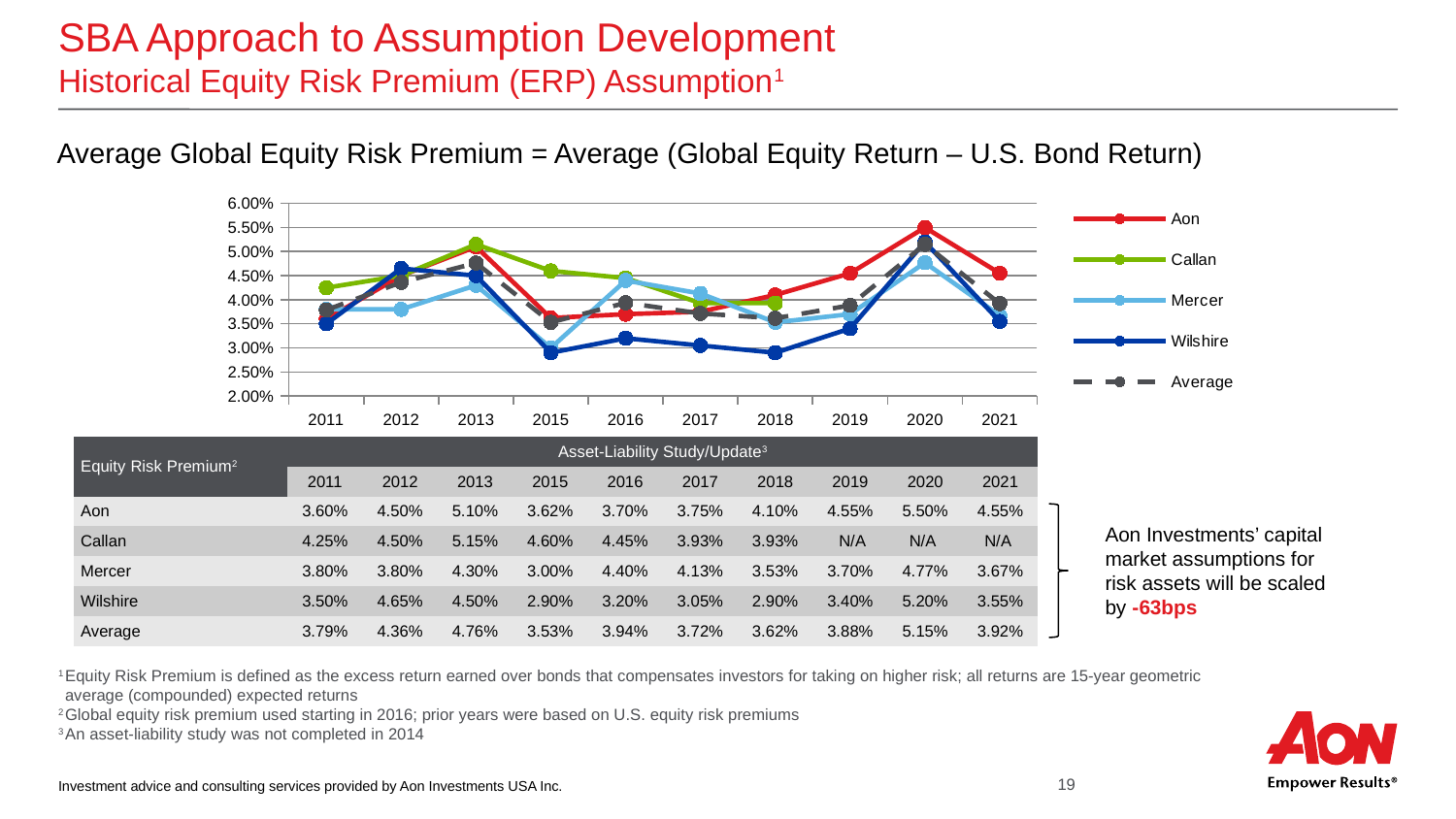
What is the Aon equity risk premium value for 2020? 5.50% What is the Mercer value for 2013? 4.30% Which is larger in 2018, the Aon value or the Wilshire value? Aon In which year is the Mercer series at its lowest? 2015 Does the Aon series rise or fall from 2018 to 2020? rise What is the Wilshire value for 2015? 2.90% How many series does the chart legend list? 5 In which year is the Aon series at its highest? 2020 How many years are plotted on the x axis of the chart? 10 What is the difference between the Aon and Wilshire values in 2020? 0.30% Is the Wilshire value for 2018 greater or less than 3.50%? less What kind of chart is shown on the slide? line chart